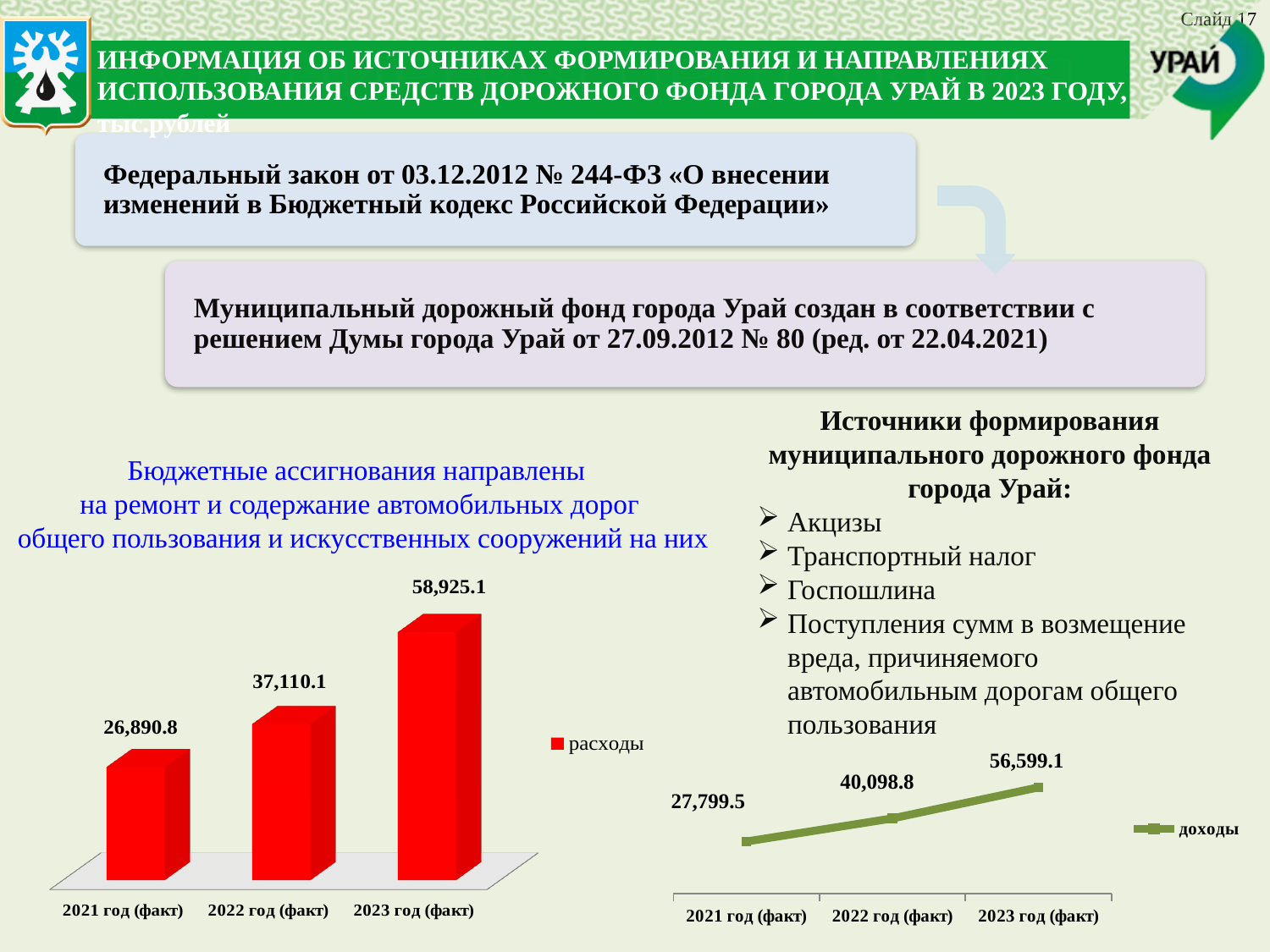
What kind of chart is the chart on the left (расходы)? bar chart In the bar chart on the left (расходы), what is the difference between the values for 2023 год (факт) and 2022 год (факт)? 21,815.0 In the line chart on the right (доходы), do the values rise or fall from 2021 to 2023? rise In the bar chart on the left (расходы), which year has the lowest value? 2021 год (факт) In the line chart on the right (доходы), what is the value for 2023 год (факт)? 56,599.1 In the bar chart on the left (расходы), which year has the highest value? 2023 год (факт) In the bar chart on the left (расходы), what is the value for 2022 год (факт)? 37,110.1 In the bar chart on the left (расходы), what is the value for 2021 год (факт)? 26,890.8 In the line chart on the right (доходы), what is the value for 2021 год (факт)? 27,799.5 In the line chart on the right (доходы), what is the difference between the values for 2022 год (факт) and 2021 год (факт)? 12,299.3 How many categories are shown on the x axis of the line chart on the right (доходы)? 3 What is the legend entry of the bar chart on the left? расходы